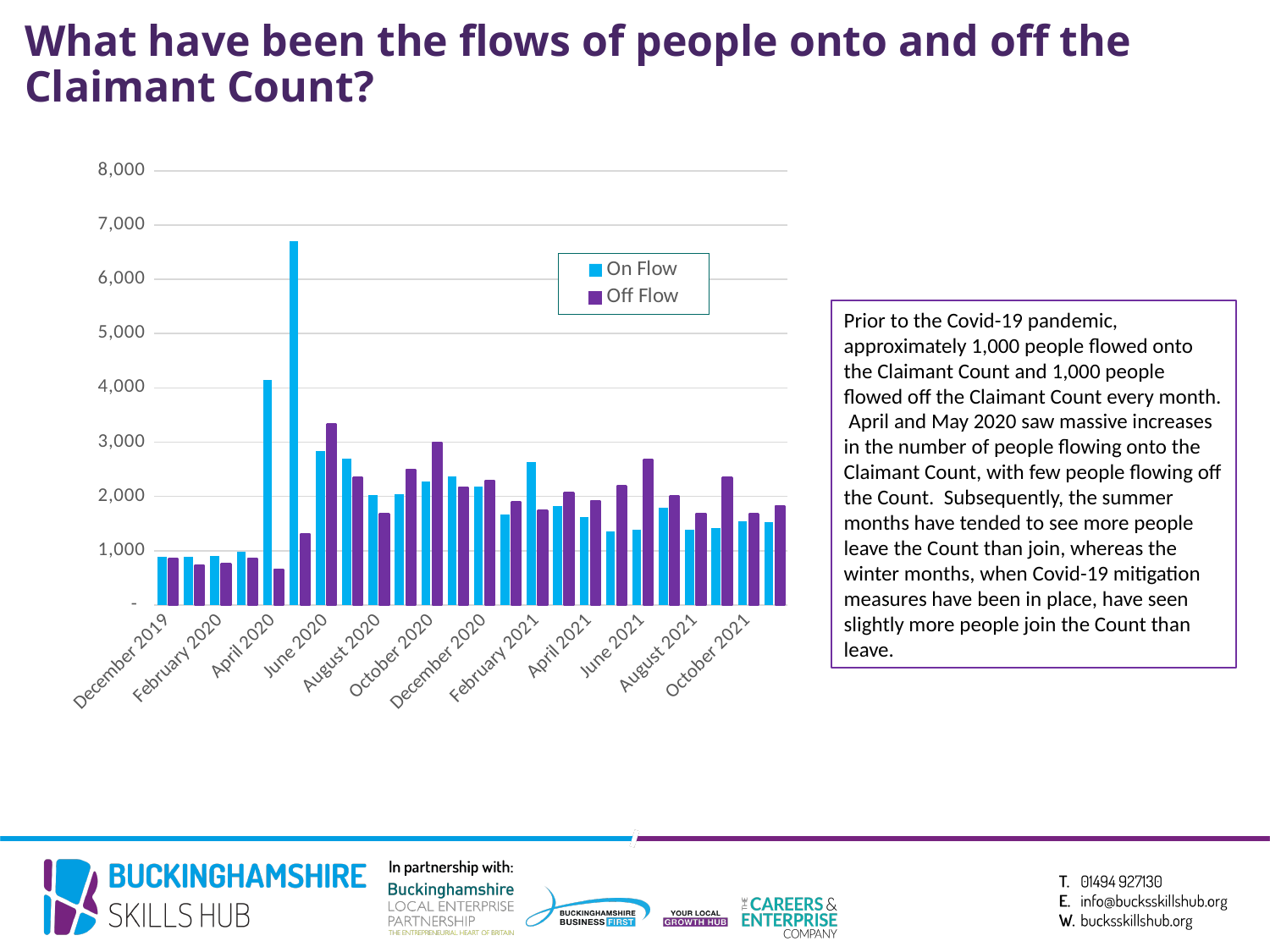
In June 2021, which is larger: On Flow or Off Flow? Off Flow Which colour represents Off Flow in the chart? Purple How many month labels are shown on the x axis? 12 In April 2020, which is larger: On Flow or Off Flow? On Flow Is the On Flow value for June 2021 greater or less than 2,000? less What are the two series named in the legend? On Flow and Off Flow How many series does the legend list? 2 Is the Off Flow value for April 2020 greater or less than 1,000? less Is the Off Flow value for June 2020 greater or less than 3,000? greater What kind of chart is shown on the slide? Bar chart Which series contains the tallest bar in the chart? On Flow